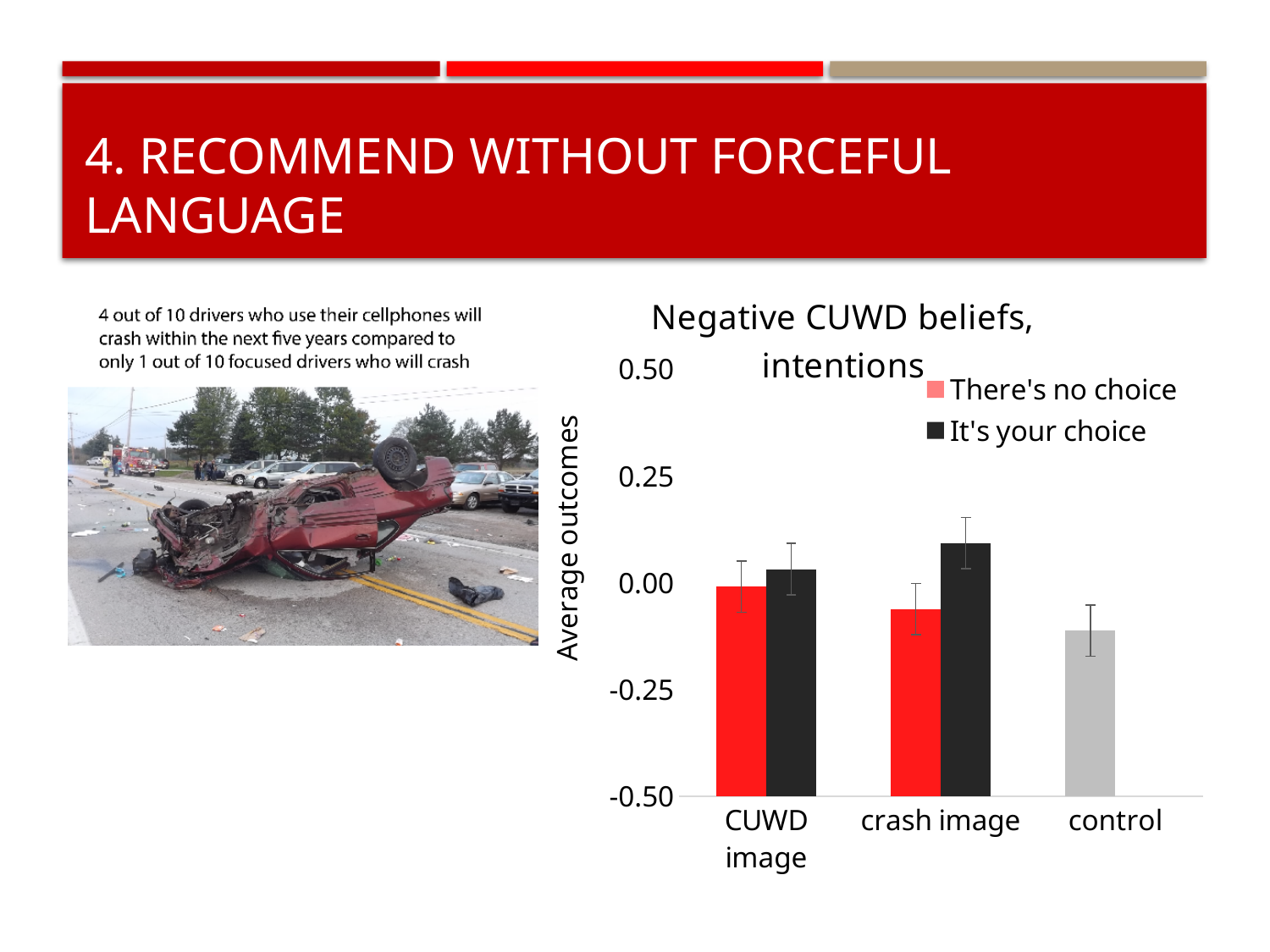
What is the title of the chart? Negative CUWD beliefs, intentions Which bar in the chart has the highest value? It's your choice, crash image In the crash image condition, which series has the larger value: "There's no choice" or "It's your choice"? It's your choice What kind of chart is shown on the slide? bar chart Is the value for "It's your choice" in the crash image condition greater or less than 0.25? less How many series does the chart's legend list? 2 How many categories are shown on the x axis of the chart? 3 Which bar in the chart has the lowest value? control Is the value for "It's your choice" in the crash image condition greater or less than 0.00? greater Is the value for the control condition greater or less than 0.00? less What is the label on the chart's vertical axis? Average outcomes